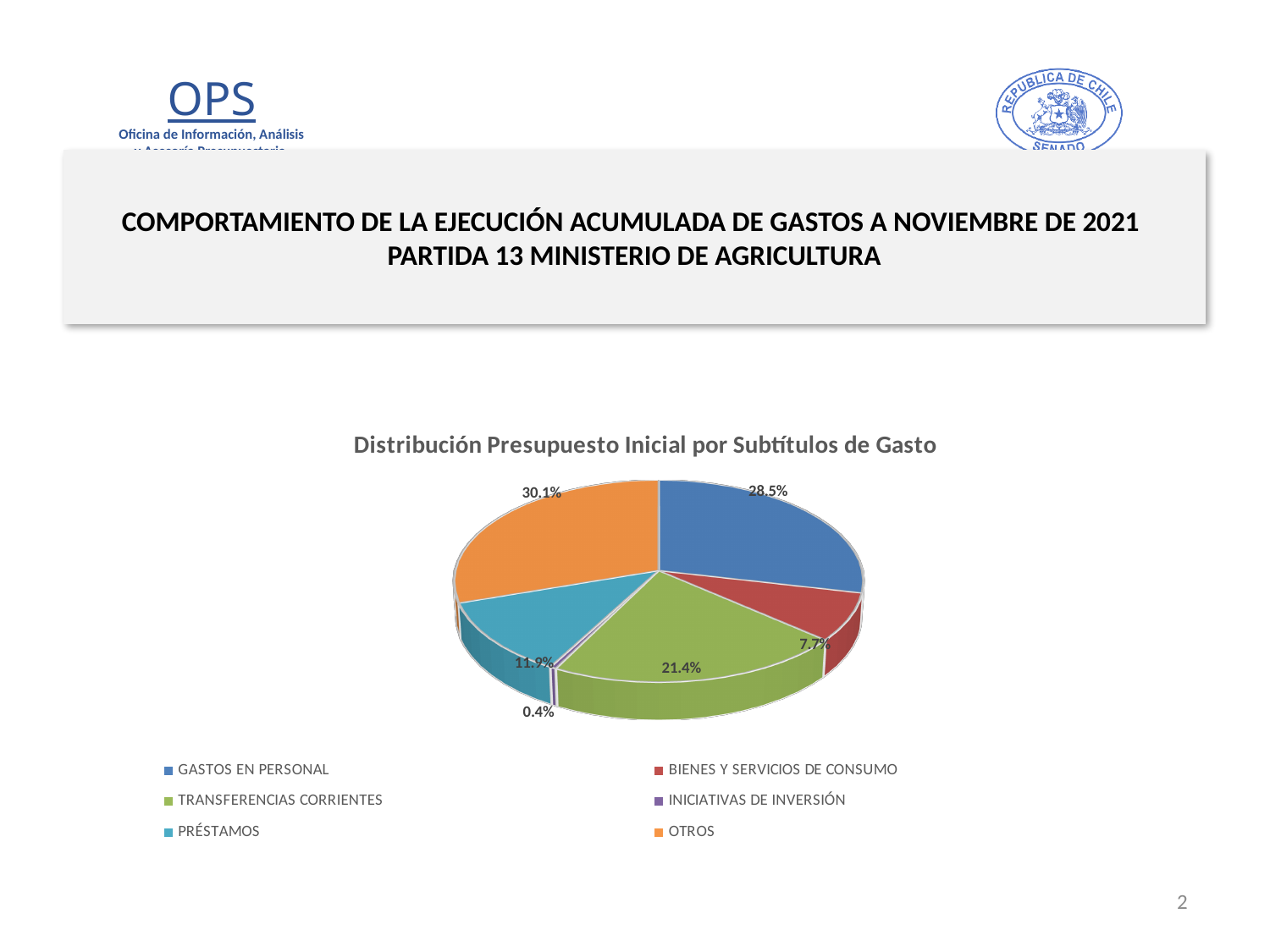
Which category has the largest slice of the pie? OTROS What is the difference in percentage points between GASTOS EN PERSONAL and TRANSFERENCIAS CORRIENTES? 7.1 How many categories does the legend list? 6 What share of the pie does OTROS represent? 30.1% What share of the pie does TRANSFERENCIAS CORRIENTES represent? 21.4% What kind of chart is shown on the slide? Pie chart What is the title of the chart? Distribución Presupuesto Inicial por Subtítulos de Gasto What share of the pie does PRÉSTAMOS represent? 11.9% Which category has the smallest slice of the pie? INICIATIVAS DE INVERSIÓN Which is larger, the share for PRÉSTAMOS or the share for BIENES Y SERVICIOS DE CONSUMO? PRÉSTAMOS